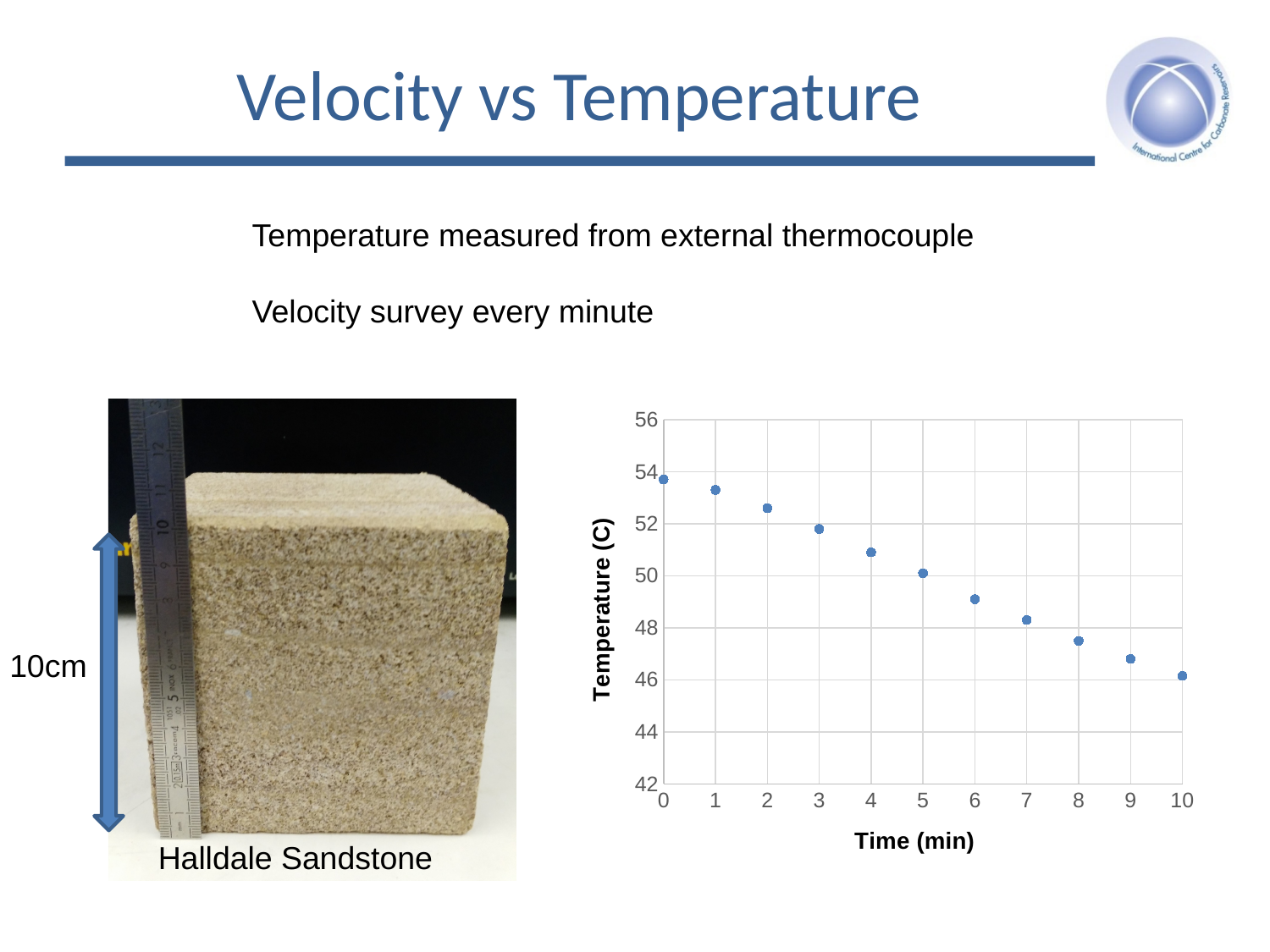
Do the temperature values rise or fall as time increases along the x axis? fall Is the temperature at 8 min greater or less than 46? greater What kind of chart is shown on the slide? scatter chart Is the temperature at 0 min greater or less than 52? greater How many data points are plotted in the chart? 11 What is the label of the x axis of the chart? Time (min) What is the label of the y axis of the chart? Temperature (C) At which time (min) is the temperature lowest? 10 Which has the higher temperature, 2 min or 7 min? 2 min Is the temperature at 10 min greater or less than 48? less At which time (min) is the temperature highest? 0